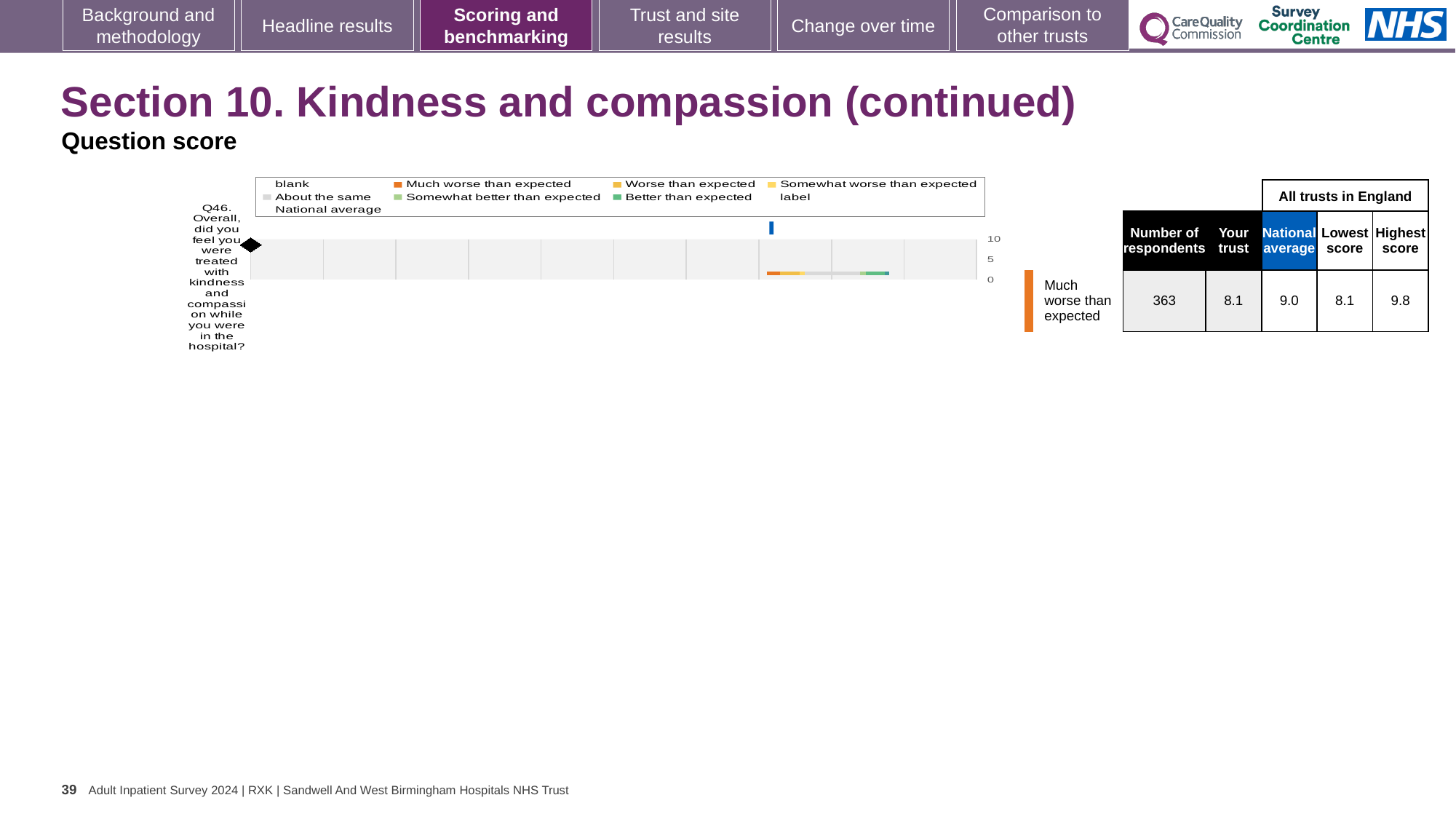
In the table beside the chart, what is the lowest score among all trusts in England for Q46? 8.1 How much lower is the trust's score than the national average for Q46? 0.9 Which survey question is the chart about? Q46. Overall, did you feel you were treated with kindness and compassion while you were in the hospital? How many entries does the chart's legend list? 9 In the table beside the chart, what is the score for 'Your trust' on Q46? 8.1 What is the highest tick value shown on the chart's axis? 10 In the table beside the chart, what is the national average score for Q46? 9.0 Which is larger for Q46: the trust's score or the national average? National average Is the trust's score for Q46 greater or less than 5? greater What is the difference between the highest score and the lowest score among all trusts in England for Q46? 1.7 In the table beside the chart, what is the highest score among all trusts in England for Q46? 9.8 In the table beside the chart, what is the number of respondents for Q46? 363